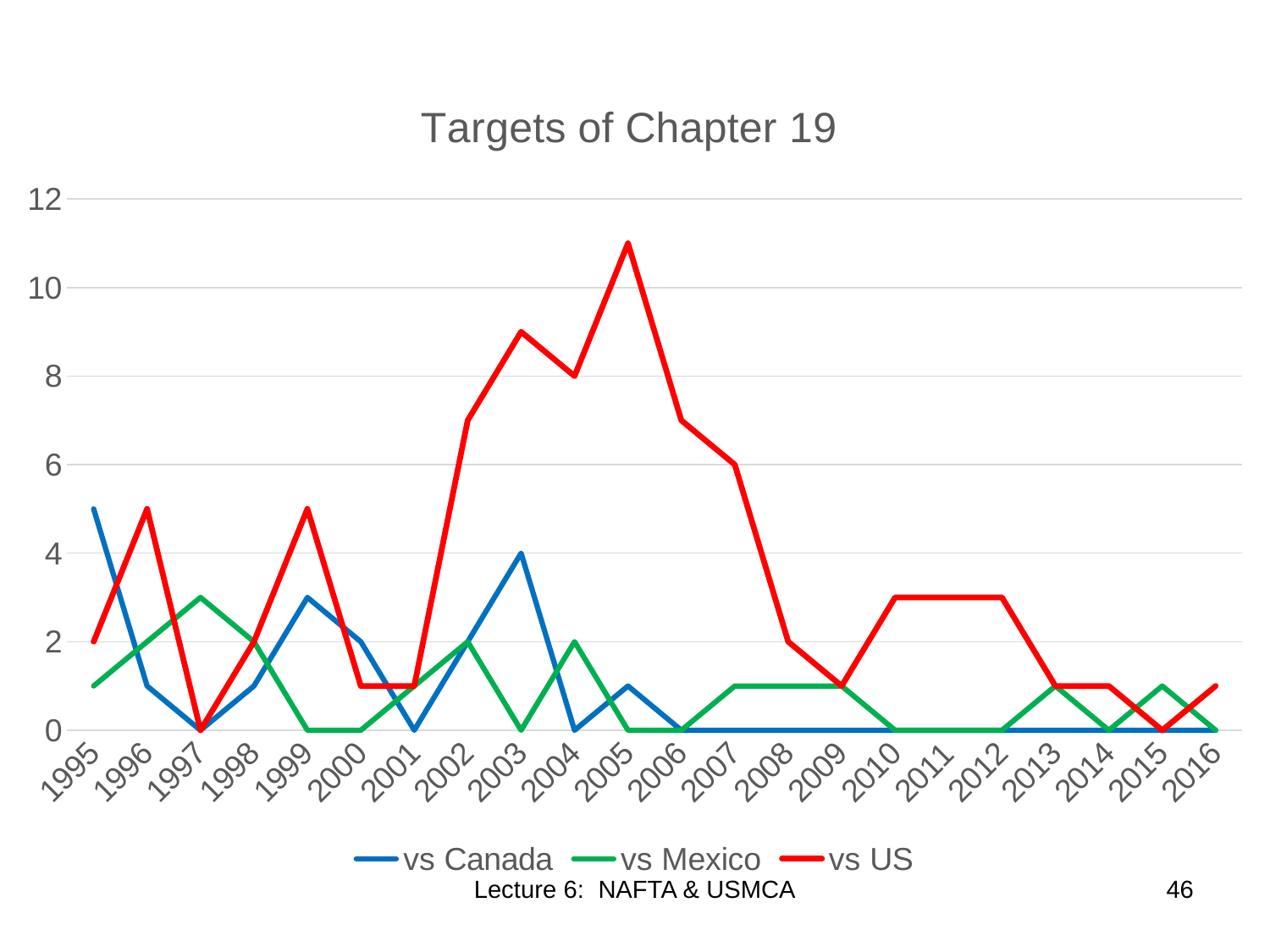
What is the value of the vs US series in 2004? 8 What is the title of the chart? Targets of Chapter 19 Does the vs US series rise or fall from 2005 to 2008? fall In which year does the vs US series reach its highest value? 2005 How many years are shown along the x axis? 22 What kind of chart is shown on the slide? line chart Is the value for vs US in 2005 greater or less than 10? greater What is the value of the vs Canada series in 2003? 4 Which series has the larger value in 2005, vs US or vs Canada? vs US How many series does the legend list? 3 Is the value for vs Canada in 1995 greater or less than 4? greater What is the value of the vs US series in 2007? 6